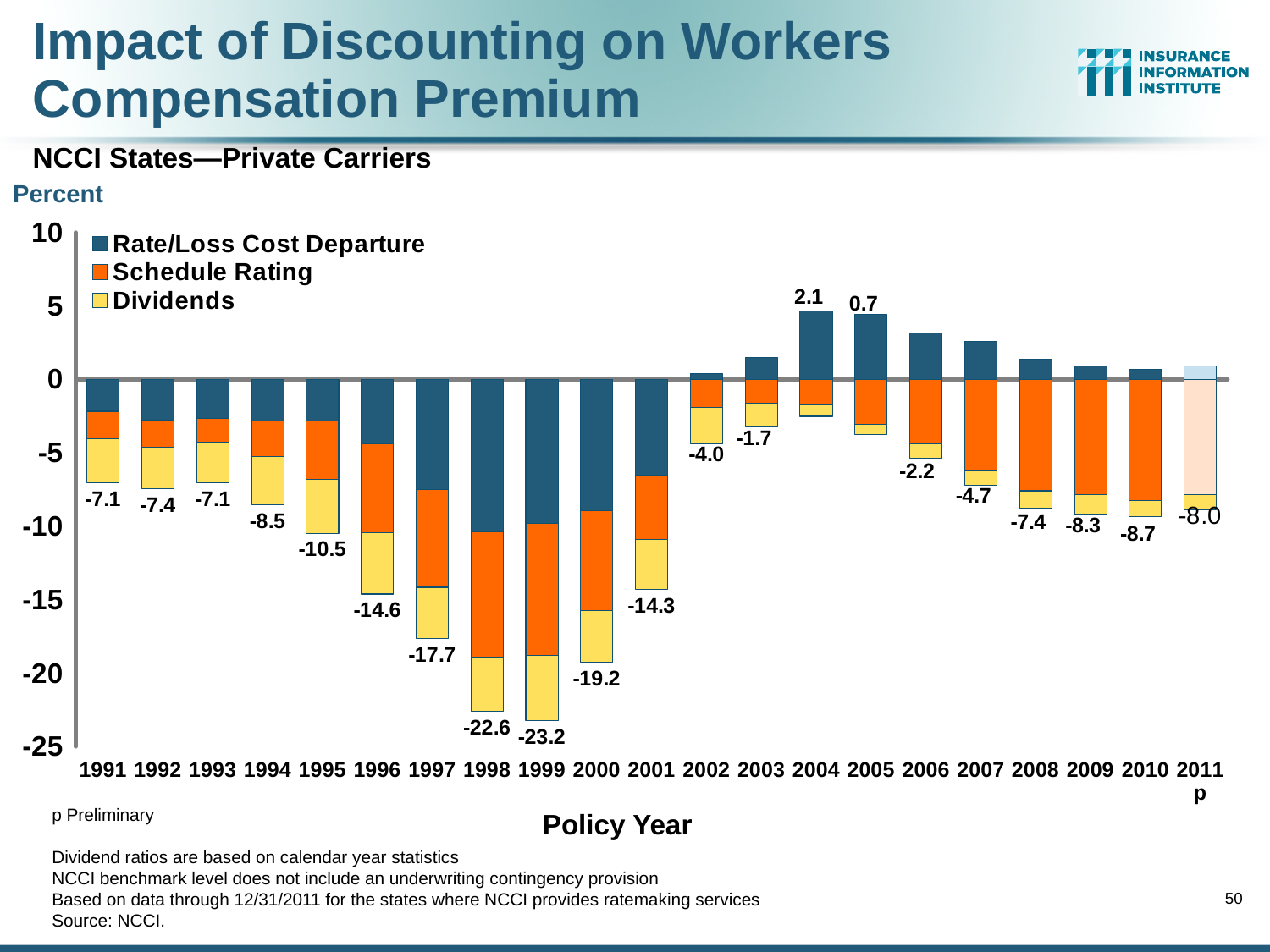
What is the labeled net value for policy year 1999? -23.2 Which policy year has the lowest (most negative) labeled net value? 1999 Which policy year has a larger labeled net value, 2005 or 2006? 2005 Which policy year has the highest labeled net value? 2004 What is the labeled net value for policy year 2004? 2.1 How many policy years are shown on the x axis? 21 How many series does the legend list? 3 What is the difference between the labeled net values for 1998 and 1999? 0.6 Do the labeled net values rise or fall from 1991 to 1999? Fall What type of chart is shown on the slide? Stacked bar chart What is the labeled net value for policy year 2011p? -8.0 Which series is shown in yellow in the legend? Dividends